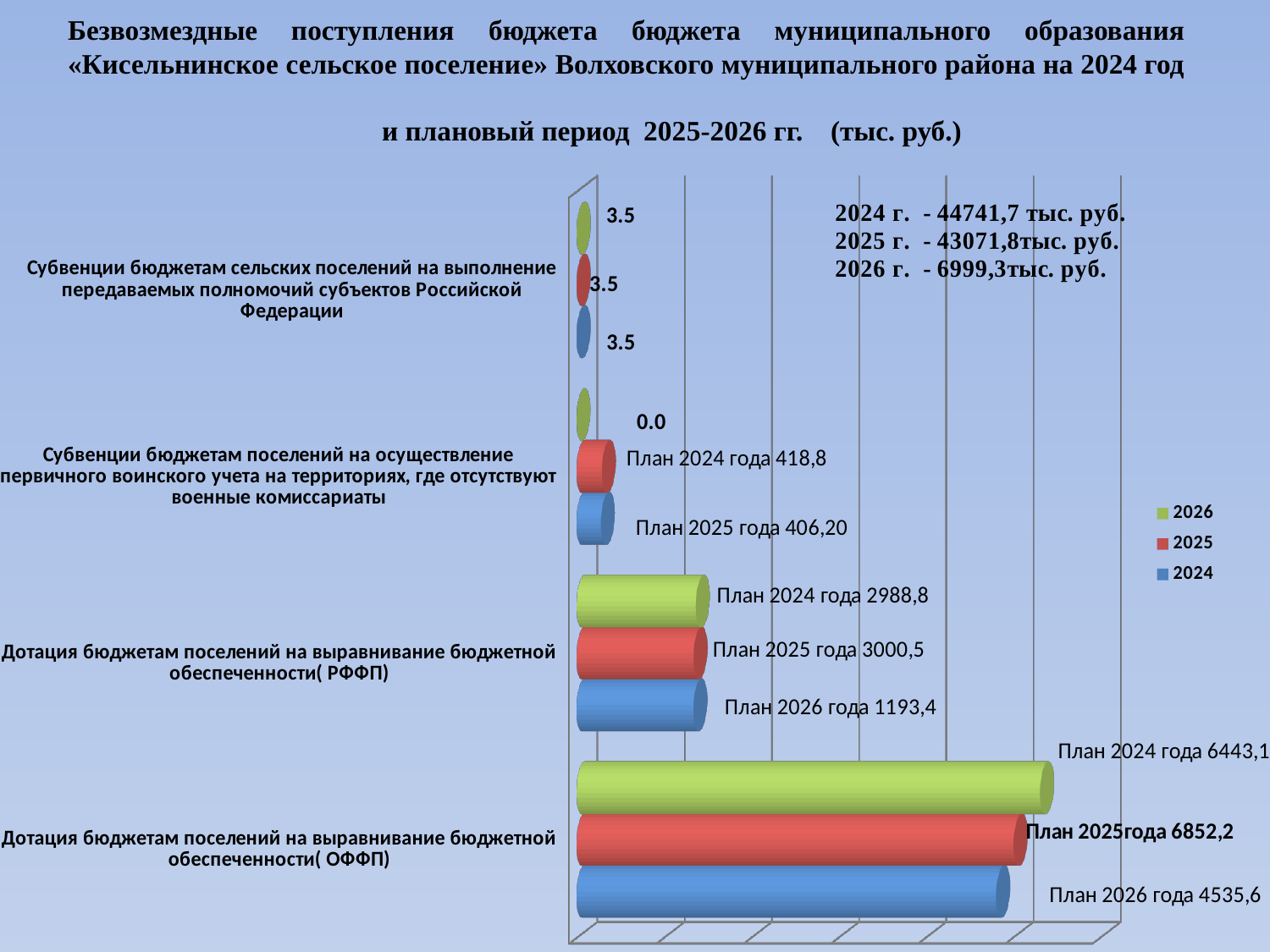
In the category 'Дотация бюджетам поселений на выравнивание бюджетной обеспеченности (ОФФП)', what value is given in the label 'План 2025 года'? 6852,2 In the category 'Дотация бюджетам поселений на выравнивание бюджетной обеспеченности (ОФФП)', what value is given in the label 'План 2026 года'? 4535,6 In the category 'Дотация бюджетам поселений на выравнивание бюджетной обеспеченности (РФФП)', what value is given in the label 'План 2024 года'? 2988,8 In the РФФП category, which is larger: the value labelled 'План 2025 года' or the value labelled 'План 2026 года'? План 2025 года (3000,5) How many categories are shown on the chart's vertical axis? 4 In the category 'Субвенции бюджетам поселений на осуществление первичного воинского учета', what value is given in the label 'План 2025 года'? 406,20 What kind of chart is shown on the slide? bar chart In the ОФФП category, what is the difference between the values labelled 'План 2025 года' (6852,2) and 'План 2024 года' (6443,1)? 409,1 What value is labelled on each of the three bars for the category 'Субвенции бюджетам сельских поселений на выполнение передаваемых полномочий субъектов Российской Федерации'? 3.5 How many series does the chart legend list? 3 Which years are listed in the chart legend? 2026, 2025, 2024 Which category has the longest bars on the chart? Дотация бюджетам поселений на выравнивание бюджетной обеспеченности (ОФФП)